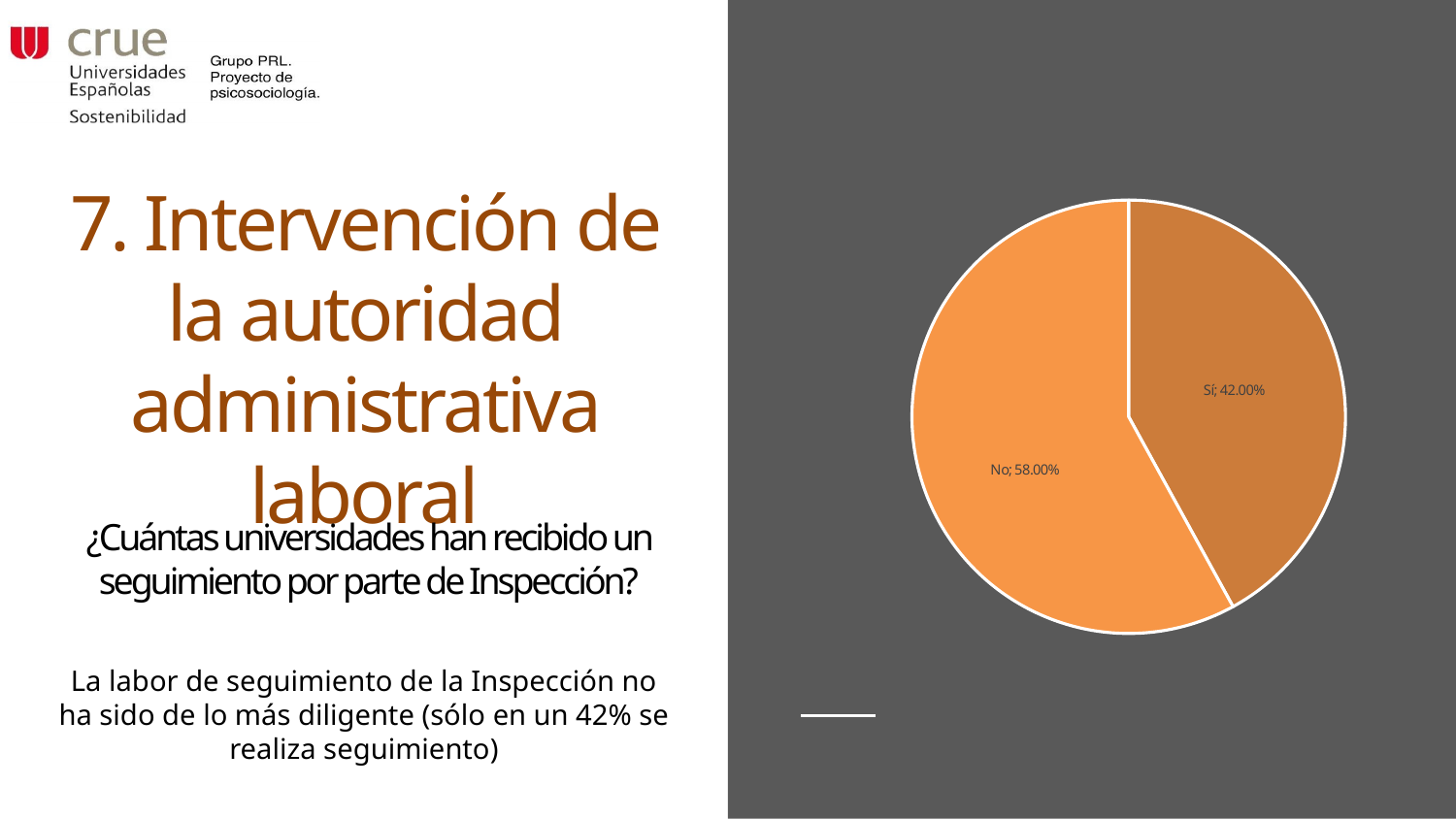
Which slice of the pie chart is the smallest? Sí Which is larger in the pie chart, "Sí" or "No"? No What is the value for the "No" slice of the pie chart? 58.00% What is the total of the two slices in the pie chart? 100.00% What kind of chart is shown on the slide? pie chart Which slice of the pie chart is the largest? No Is the value for "No" in the pie chart greater or less than 50%? greater What is the difference between the "No" and "Sí" slices of the pie chart? 16.00% What share of the pie does the "Sí" slice represent? 42.00% Is the value for "Sí" in the pie chart greater or less than 50%? less What is the value for the "Sí" slice of the pie chart? 42.00% How many slices does the pie chart have? 2